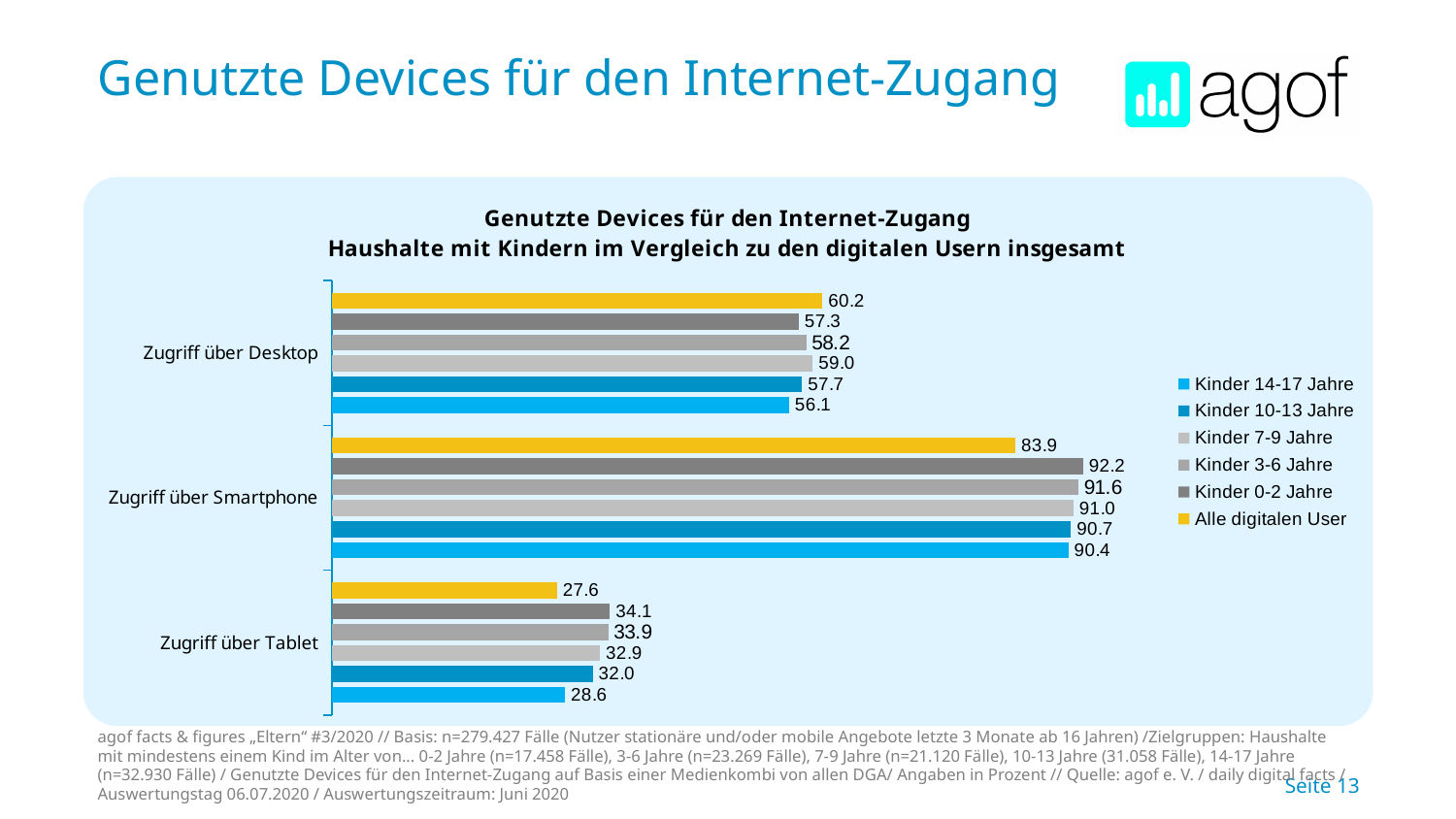
What is the value for Kinder 0-2 Jahre for Zugriff über Smartphone? 92.2 What is the value for Kinder 14-17 Jahre for Zugriff über Tablet? 28.6 How many series does the legend list? 6 What kind of chart is shown on the slide? Bar chart Which colour represents Alle digitalen User in the chart? Yellow What is the value for Kinder 7-9 Jahre for Zugriff über Desktop? 59.0 Which series has the highest value for Zugriff über Smartphone? Kinder 0-2 Jahre What is the difference between Kinder 0-2 Jahre and Alle digitalen User for Zugriff über Smartphone? 8.3 What is the value for Alle digitalen User for Zugriff über Desktop? 60.2 Which is larger for Zugriff über Desktop: Alle digitalen User or Kinder 14-17 Jahre? Alle digitalen User How many device categories are shown on the chart? 3 Which series has the lowest value for Zugriff über Tablet? Alle digitalen User